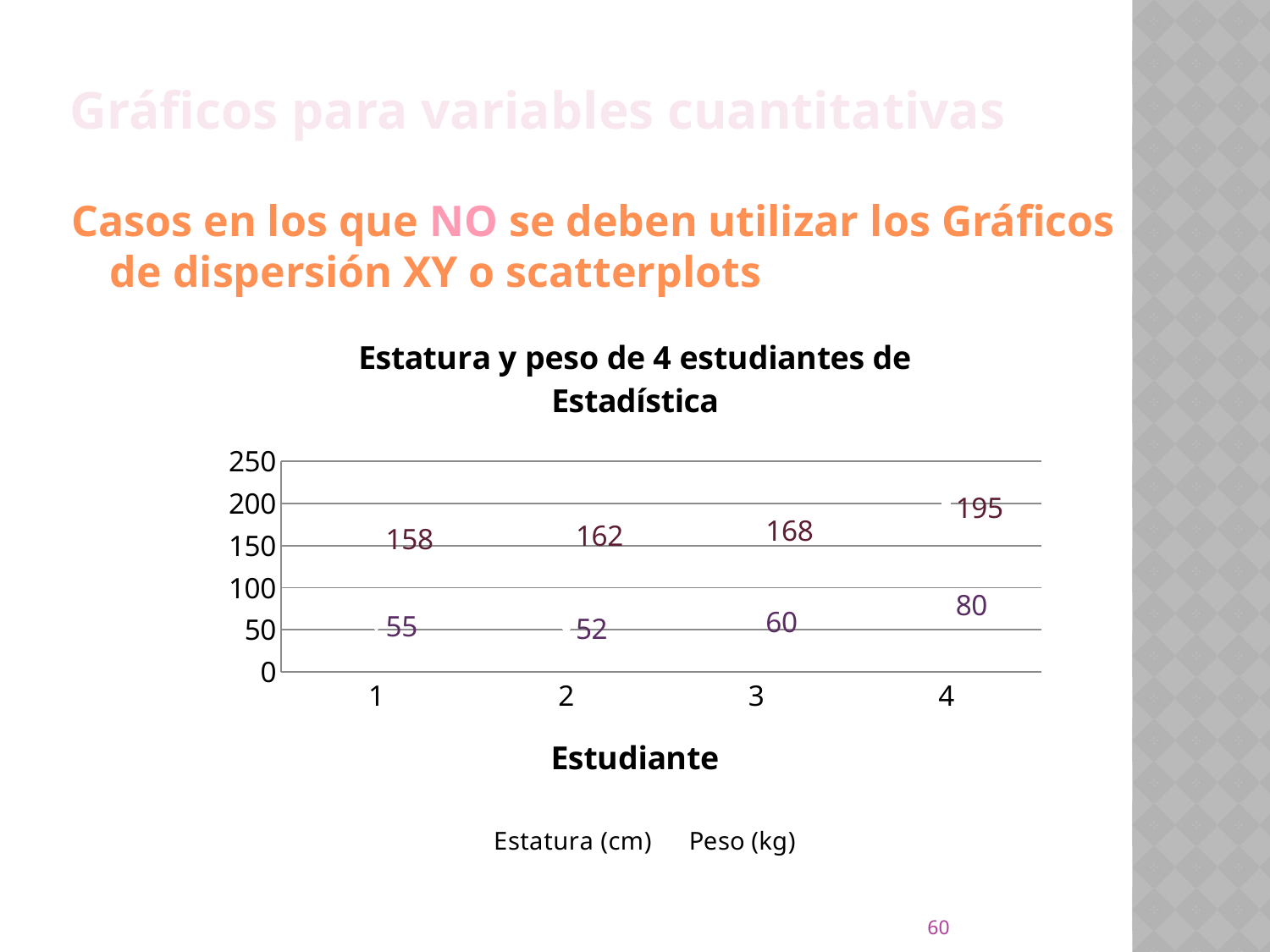
Which is larger, the Peso (kg) of student 1 or of student 2? student 1 What is the title of the chart? Estatura y peso de 4 estudiantes de Estadística How many series does the legend list? 2 What kind of chart is shown on the slide? line chart What is the difference between the Estatura (cm) of student 4 and student 1? 37 What is the difference between the Peso (kg) of student 4 and student 3? 20 What is the Estatura (cm) value for student 4? 195 What is the Peso (kg) value for student 2? 52 How many students are plotted on the x axis? 4 Which student has the lowest Peso (kg)? 2 Which student has the highest Estatura (cm)? 4 What is the Estatura (cm) value for student 3? 168